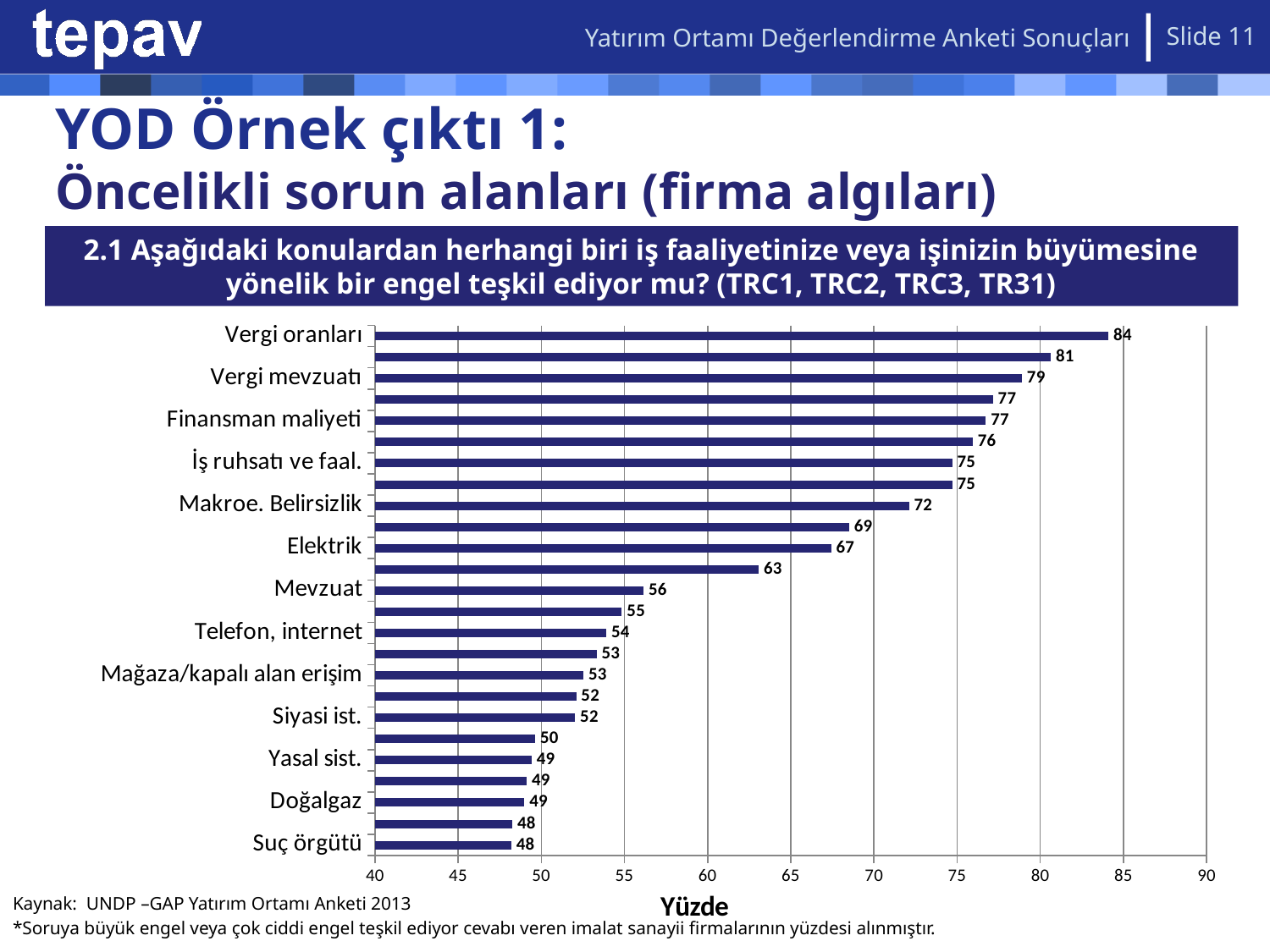
Which is larger, the value for Finansman maliyeti or the value for Elektrik? Finansman maliyeti What is the title of the horizontal axis? Yüzde Which labeled category has the highest value? Vergi oranları What is the value for Vergi oranları? 84 What is the difference between the values for Vergi oranları and Mevzuat? 28 What type of chart is shown on the slide? bar chart What is the value for Telefon, internet? 54 What is the value for Makroe. Belirsizlik? 72 What is the value for Suç örgütü? 48 Which labeled category has the lowest value? Suç örgütü Is the value for Siyasi ist. greater or less than 60? less What is the value for Elektrik? 67